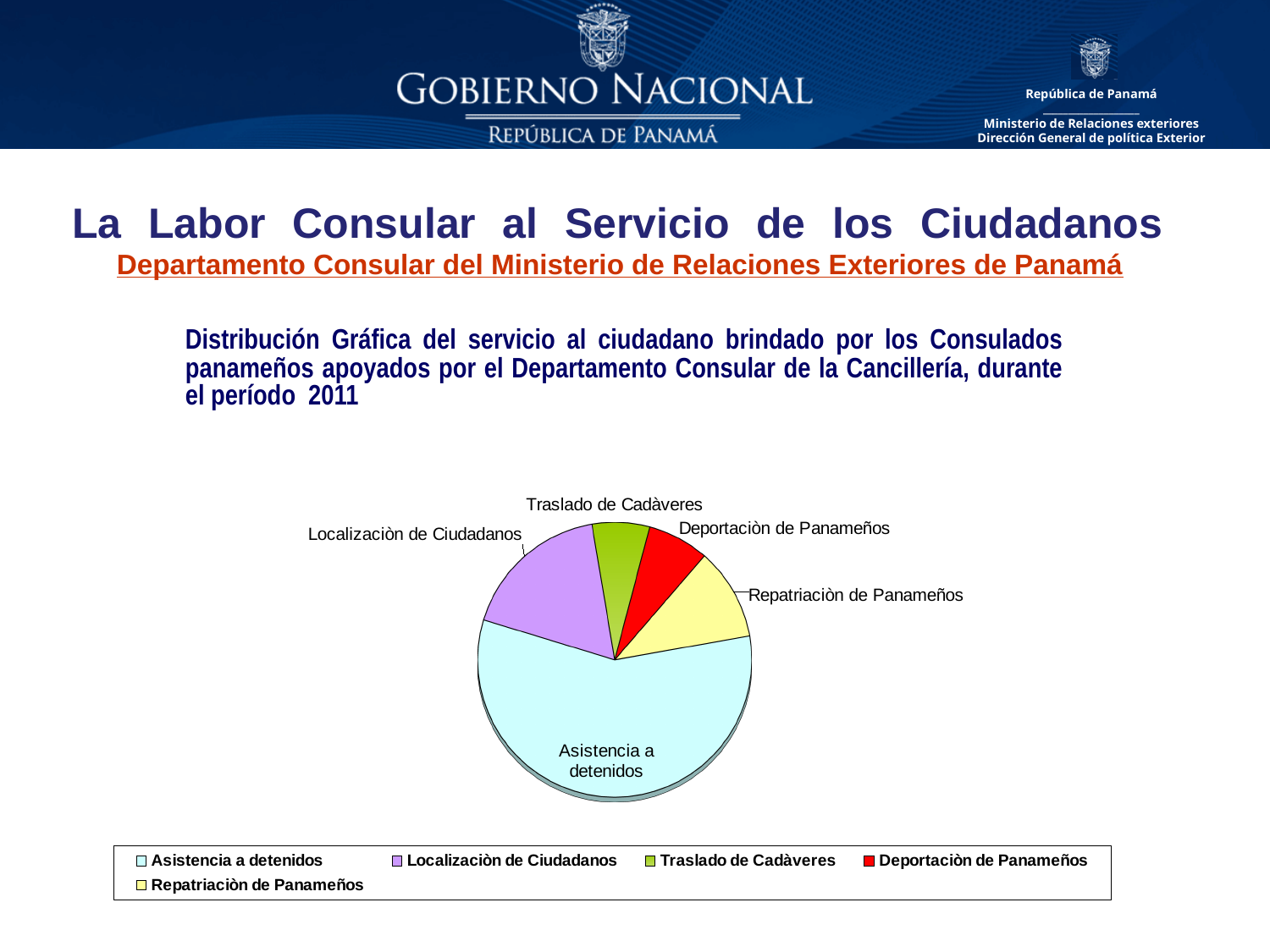
What kind of chart is shown on the slide? pie chart Which slice is larger, Asistencia a detenidos or Deportaciòn de Panameños? Asistencia a detenidos Which slice is larger, Asistencia a detenidos or Localizaciòn de Ciudadanos? Asistencia a detenidos Which slice is larger, Localizaciòn de Ciudadanos or Repatriaciòn de Panameños? Localizaciòn de Ciudadanos How many entries does the legend of the pie chart list? 5 Which category is shown in purple in the pie chart? Localizaciòn de Ciudadanos Which category has the largest slice in the pie chart? Asistencia a detenidos What colour is the Deportaciòn de Panameños slice in the pie chart? red How many slices does the pie chart have? 5